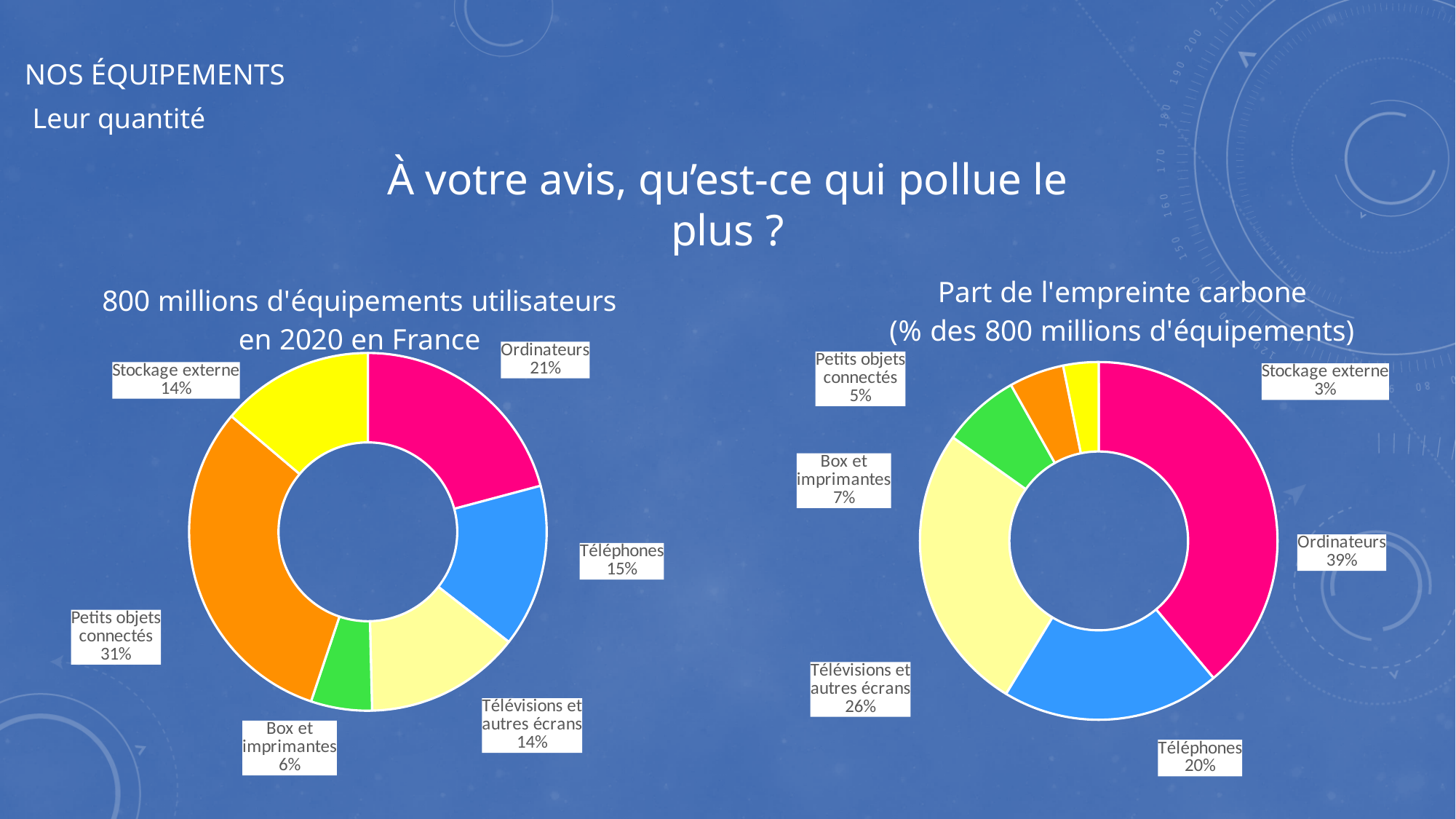
In the left chart, which category has the largest share? Petits objets connectés What kind of chart is the left chart on the slide? Doughnut (pie) chart What is the title of the right chart? Part de l'empreinte carbone (% des 800 millions d'équipements) In the left chart, which is larger: the share of Ordinateurs or the share of Téléphones? Ordinateurs In the left chart, which category has the smallest share? Box et imprimantes In the chart titled 'Part de l'empreinte carbone', what is the share for Stockage externe? 3% In the chart titled '800 millions d'équipements utilisateurs en 2020 en France', what is the share for Petits objets connectés? 31% In the right chart, what is the difference between the shares of Ordinateurs and Téléphones? 19% How many categories does the chart titled 'Part de l'empreinte carbone' show? 6 In the left chart, what is the combined share of Stockage externe and Télévisions et autres écrans? 28% In the right chart, which category has the smallest share? Stockage externe In the chart titled 'Part de l'empreinte carbone', what is the share for Ordinateurs? 39%